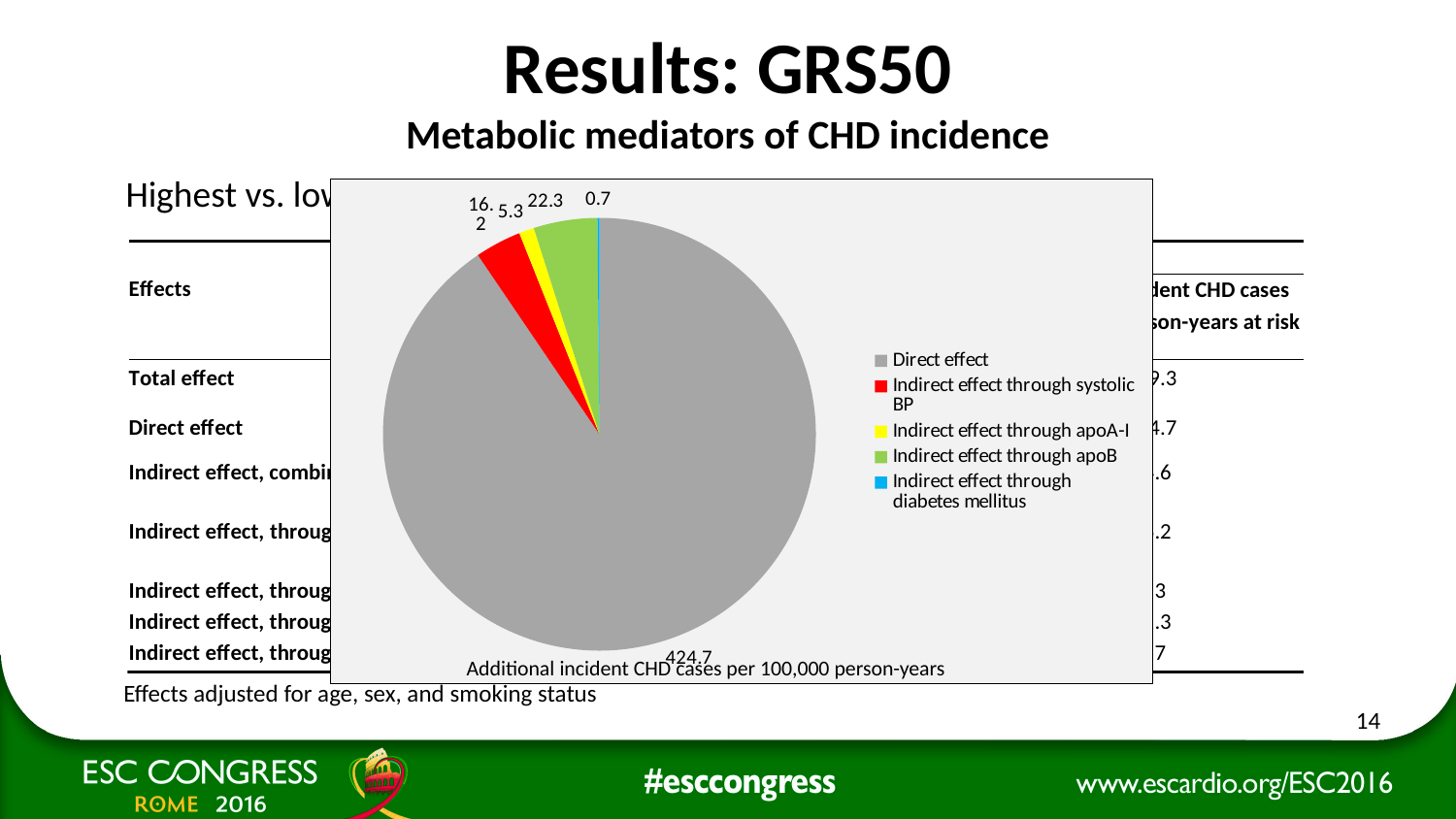
What value is shown for the Indirect effect through systolic BP slice? 16.2 Which slice of the pie chart has the largest value? Direct effect What value is shown for the Indirect effect through apoB slice? 22.3 Which slice of the pie chart has the smallest value? Indirect effect through diabetes mellitus What value is shown for the Direct effect slice of the pie chart? 424.7 How many slices does the pie chart have? 5 What type of chart is shown on the slide? Pie chart What is the difference between the Indirect effect through apoB and the Indirect effect through systolic BP values? 6.1 What colour is the Direct effect slice in the pie chart? Gray What value is shown for the Indirect effect through apoA-I slice? 5.3 Which is larger: the Indirect effect through apoB or the Indirect effect through systolic BP? Indirect effect through apoB What value is shown for the Indirect effect through diabetes mellitus slice? 0.7